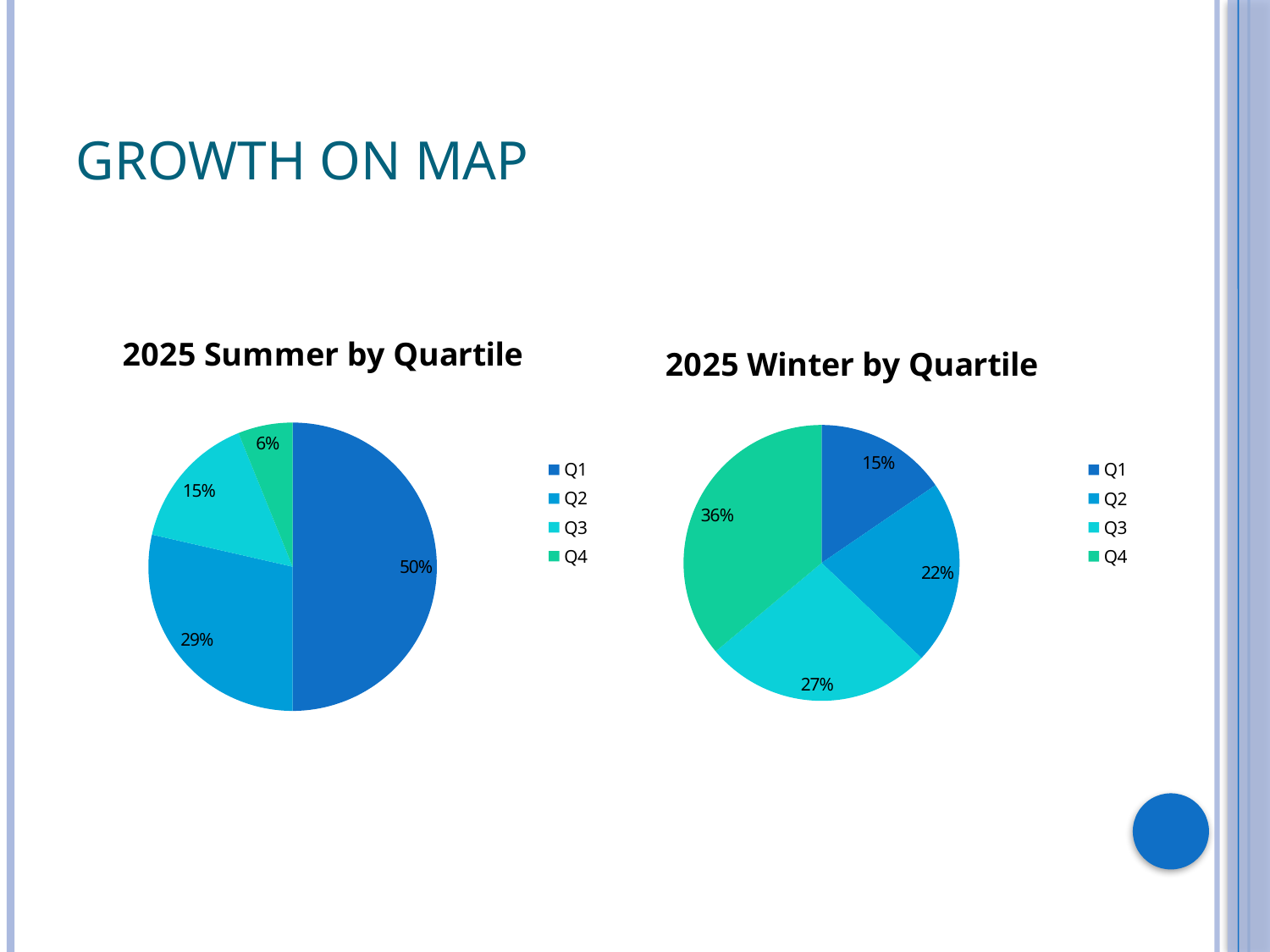
In the '2025 Winter by Quartile' chart, what share does Q4 have? 36% In the '2025 Summer by Quartile' chart, which quartile has the largest slice? Q1 In the '2025 Summer by Quartile' chart, what is the difference between the Q2 and Q3 shares? 14% How many slices does the '2025 Summer by Quartile' chart have? 4 In the '2025 Winter by Quartile' chart, which is larger, Q3 or Q2? Q3 What is the title of the chart on the left of the slide? 2025 Summer by Quartile In the '2025 Winter by Quartile' chart, what share does Q2 have? 22% In the '2025 Winter by Quartile' chart, which quartile has the smallest slice? Q1 How many entries does the legend of the '2025 Winter by Quartile' chart list? 4 What kind of chart is the '2025 Winter by Quartile' chart? Pie chart In the '2025 Summer by Quartile' chart, what share does Q4 have? 6%